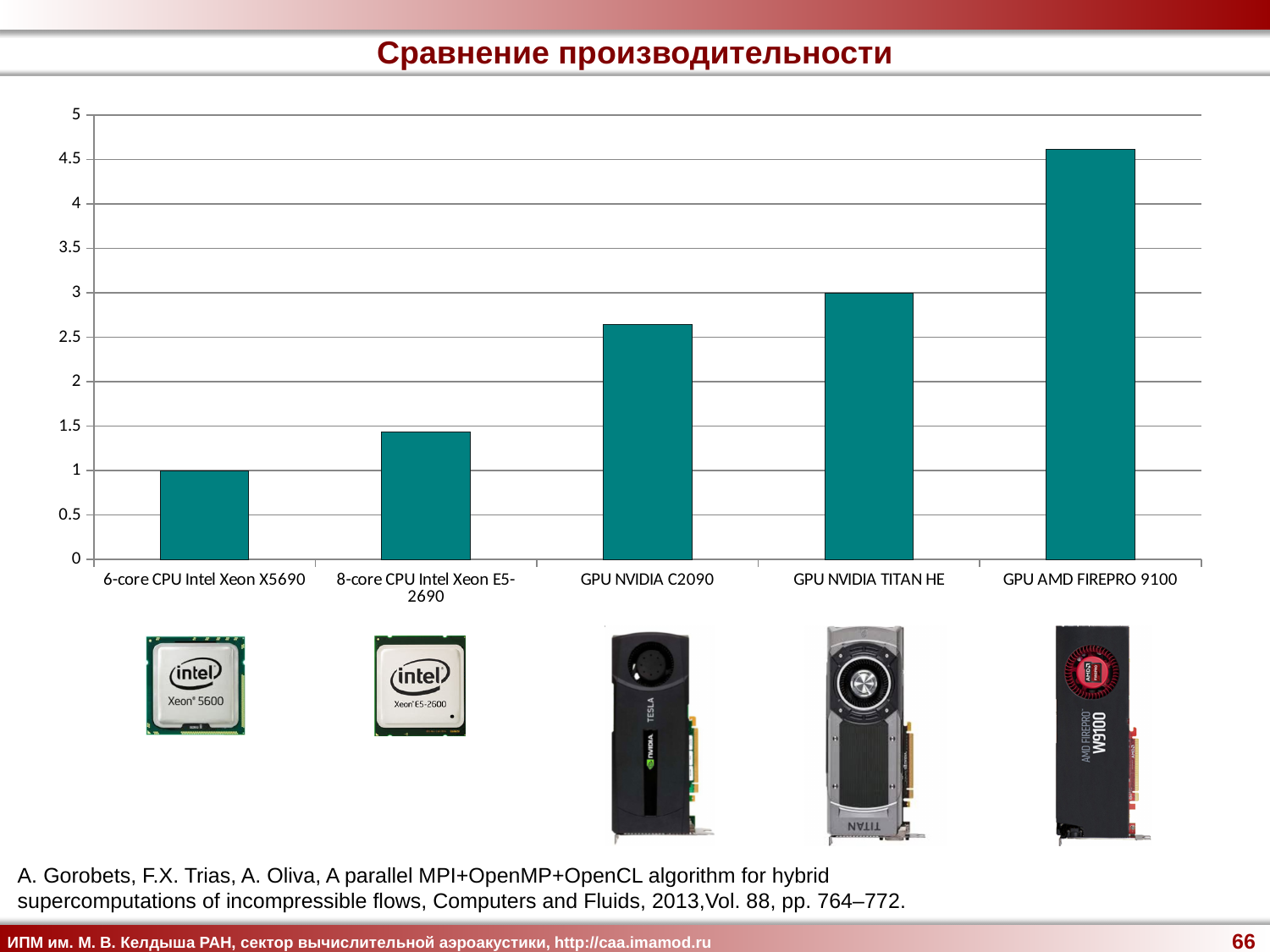
Is the value for GPU AMD FIREPRO 9100 greater or less than 4? greater How many categories (processors) are plotted in the chart? 5 What is the title of the slide containing the chart? Сравнение производительности Is the value for GPU NVIDIA C2090 greater or less than 2.5? greater Which category has the highest bar in the chart? GPU AMD FIREPRO 9100 What is the value for 6-core CPU Intel Xeon X5690? 1 Which is larger, the value for GPU NVIDIA C2090 or the value for GPU NVIDIA TITAN HE? GPU NVIDIA TITAN HE What is the value for GPU NVIDIA TITAN HE? 3 Which category has the lowest bar in the chart? 6-core CPU Intel Xeon X5690 Do the bar values rise or fall from left to right along the x axis? rise What kind of chart is shown on the slide? bar chart What is the difference between the values for GPU NVIDIA TITAN HE and 6-core CPU Intel Xeon X5690? 2